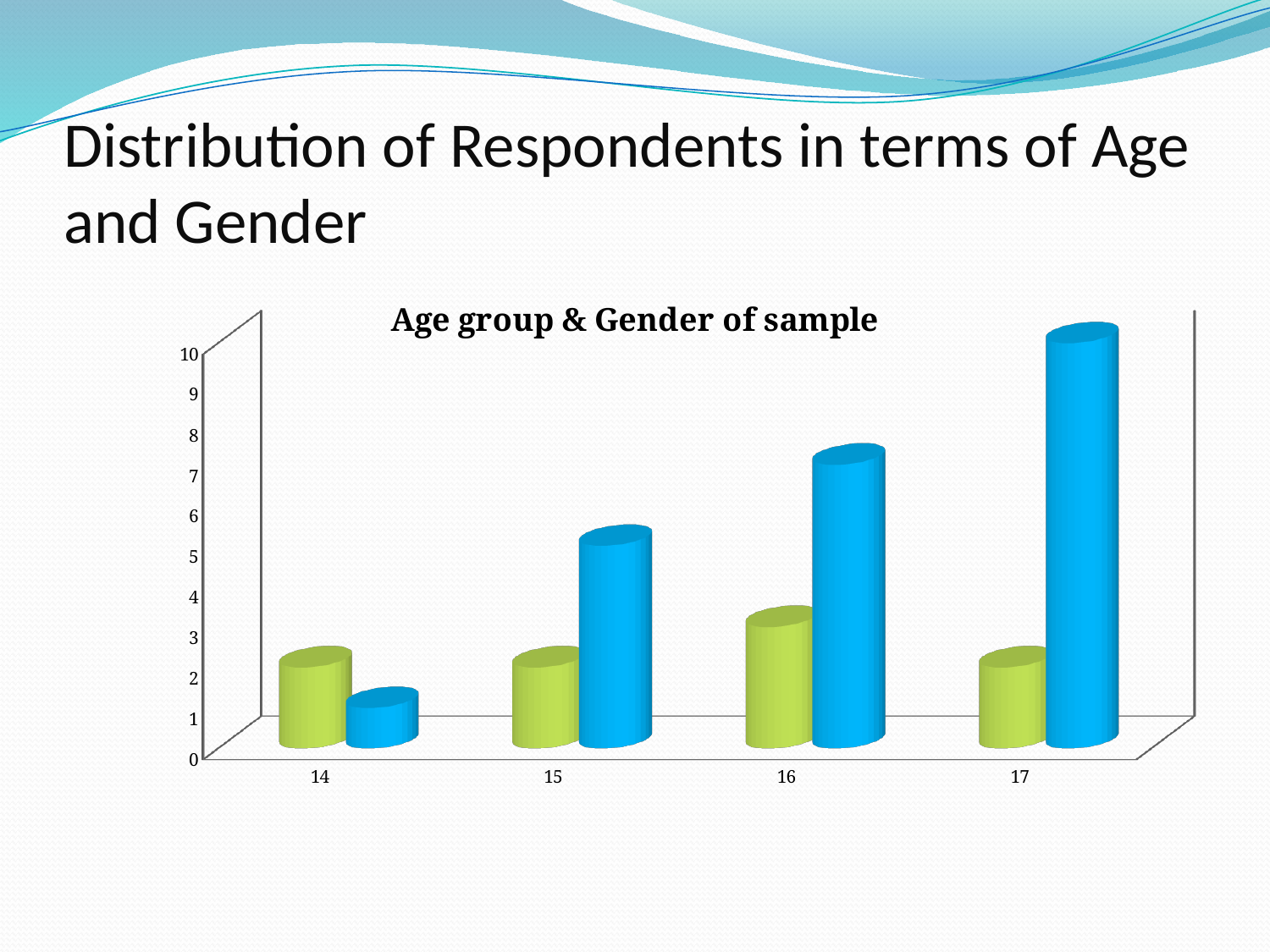
What is the title of the chart? Age group & Gender of sample For which age group is the blue bar the lowest? 14 Do the blue bars rise or fall as age increases from 14 to 17? rise Is the blue bar for age 16 greater or less than 5? greater For which age group is the blue bar the highest? 17 Is the blue bar for age 14 greater or less than 2? less For age 15, which bar is taller, the green bar or the blue bar? the blue bar How many bars are shown for each age group in the chart? 2 What kind of chart is shown on the slide? bar chart Is the green bar for age 14 greater or less than 4? less How many age groups are shown on the x axis of the chart? 4